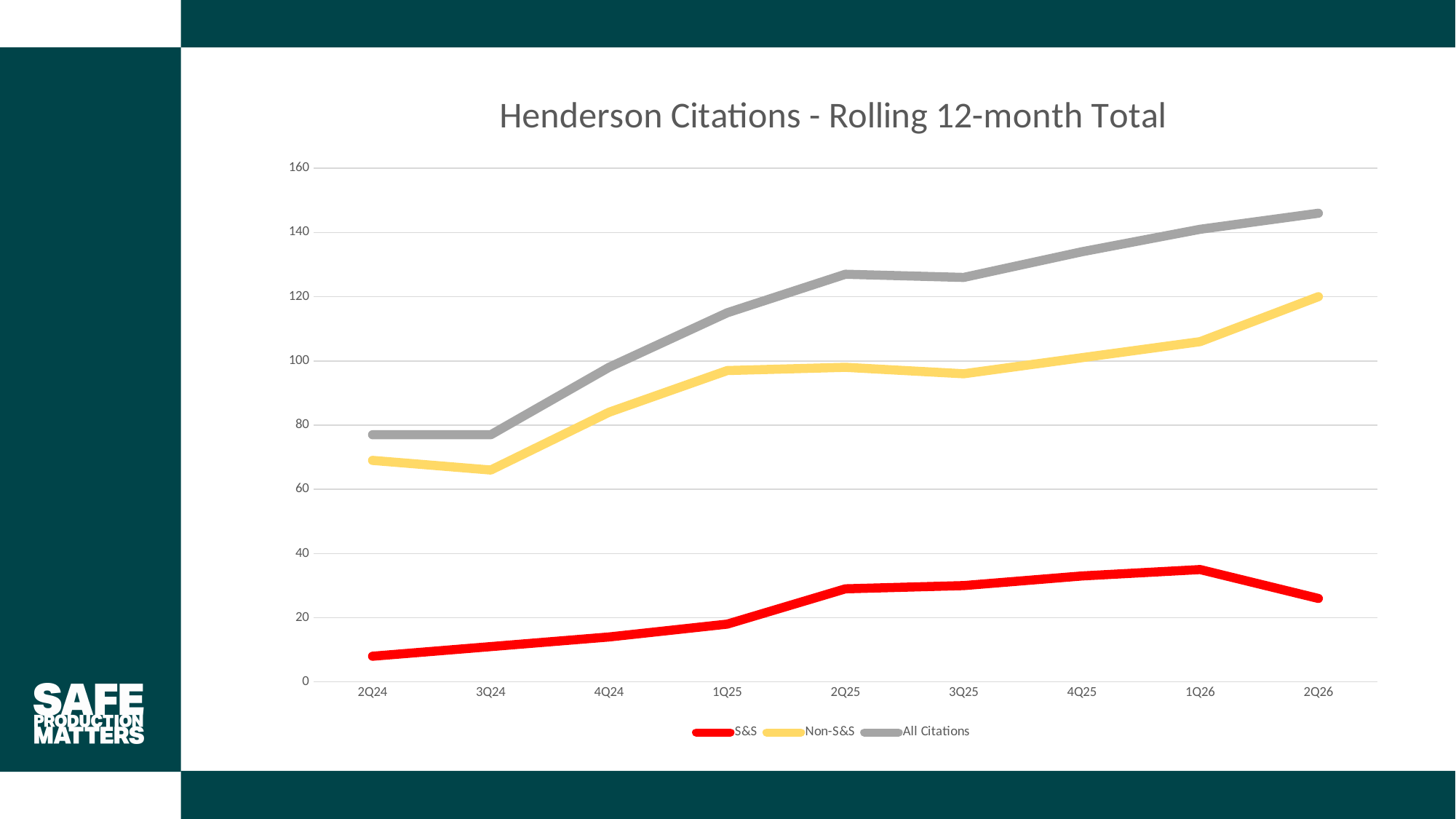
Does the All Citations series generally rise or fall from 2Q24 to 2Q26? rise How many quarters are plotted along the x axis? 9 Is the value for All Citations at 2Q25 greater or less than 120? greater What type of chart is shown on the slide? line chart How many series does the legend list? 3 Which series is larger at 2Q26, S&S or Non-S&S? Non-S&S Is the value for All Citations at 2Q26 greater or less than 140? greater Is the value for S&S at 1Q26 greater or less than 40? less What is the title of the chart? Henderson Citations - Rolling 12-month Total In which quarter is the Non-S&S series at its lowest value? 3Q24 In which quarter does the S&S series reach its highest value? 1Q26